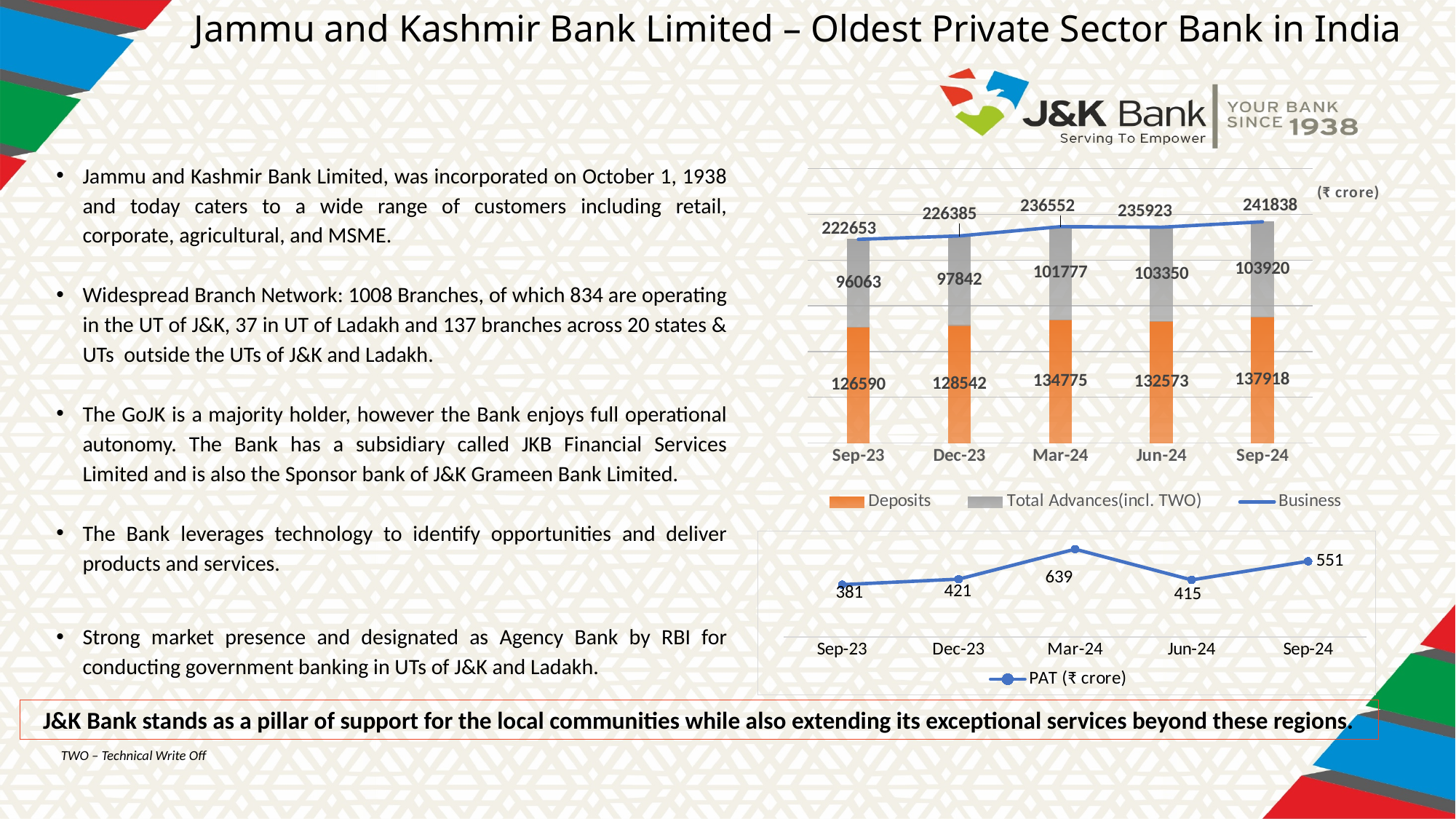
In the lower chart, what is the difference between PAT in Sep-24 and PAT in Jun-24? 136 In the upper chart, what is the value of Deposits for Sep-24? 137918 In the upper chart, which period has the lowest Deposits value? Sep-23 In the upper chart, what is the Business value for Dec-23? 226385 In the lower chart, what is the PAT (₹ crore) value for Mar-24? 639 In the lower chart, which period has the lowest PAT? Sep-23 In the upper chart, what is the total of the stacked bar for Jun-24 (Deposits plus Total Advances)? 235923 In the upper chart, what is the difference between Deposits in Sep-24 and Deposits in Sep-23? 11328 In the upper chart, which period has the highest Business value? Sep-24 How many series does the legend of the upper chart list? 3 What kind of chart is the lower chart showing PAT (₹ crore)? Line chart In the upper chart, what is the value of Total Advances(incl. TWO) for Mar-24? 101777